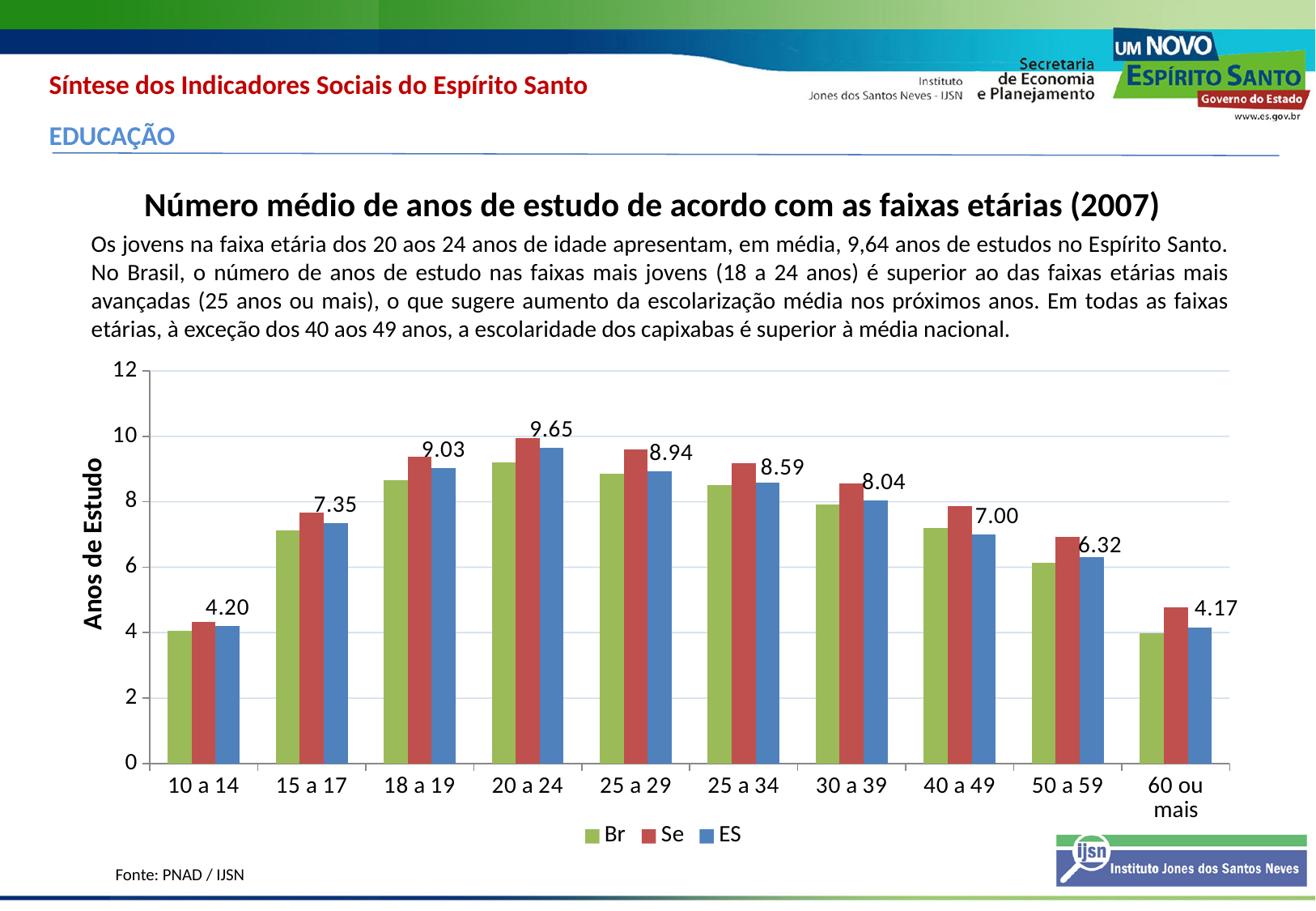
What is the value for ES in the 40 a 49 age group? 7.00 Is the value for Br in the 18 a 19 age group greater or less than 8? greater What is the difference between the ES values for 20 a 24 and 60 ou mais? 5.48 What kind of chart is shown on the slide? bar chart What is the value for ES in the 20 a 24 age group? 9.65 What is the value for ES in the 60 ou mais age group? 4.17 How many age groups are shown on the x axis? 10 How many series does the legend list? 3 Which age group has the highest ES value? 20 a 24 What is the value for ES in the 10 a 14 age group? 4.20 Which age group has the lowest ES value? 60 ou mais Which is larger for the 40 a 49 age group, the Se bar or the Br bar? Se